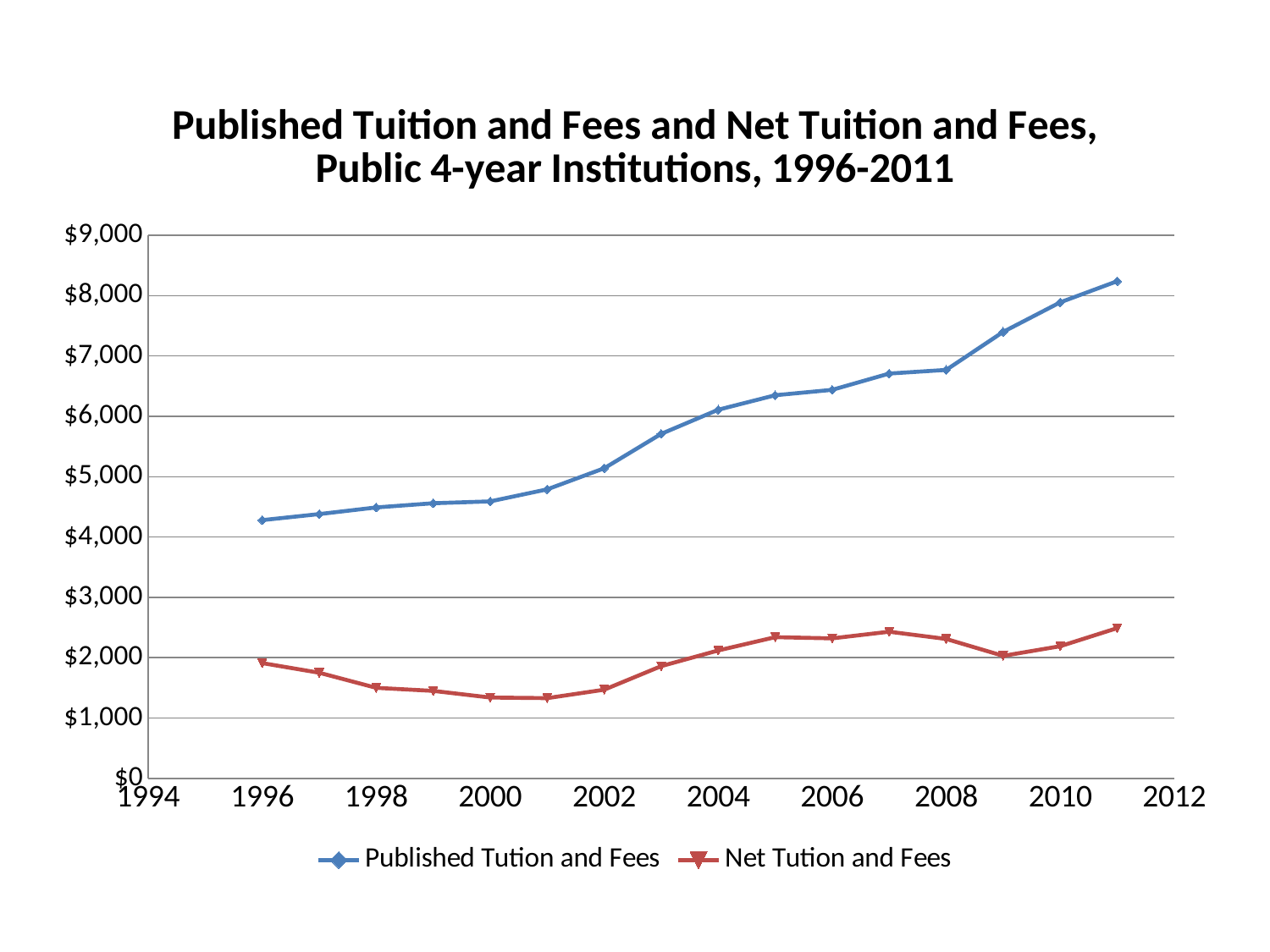
What kind of chart is shown on the slide? Line chart In which year is Published Tuition and Fees lowest? 1996 Which is larger in 2011: Published Tuition and Fees or Net Tuition and Fees? Published Tuition and Fees Is the value for Published Tuition and Fees in 2011 greater or less than $8,000? greater Does Published Tuition and Fees generally rise or fall from 1996 to 2011? rise Is the value for Net Tuition and Fees in 2000 greater or less than $2,000? less How many series does the legend list? 2 What is the title of the chart? Published Tuition and Fees and Net Tuition and Fees, Public 4-year Institutions, 1996-2011 How many data points are plotted for the Published Tuition and Fees series? 16 In which year is Published Tuition and Fees highest? 2011 Is the value for Net Tuition and Fees in 2007 greater or less than $2,000? greater